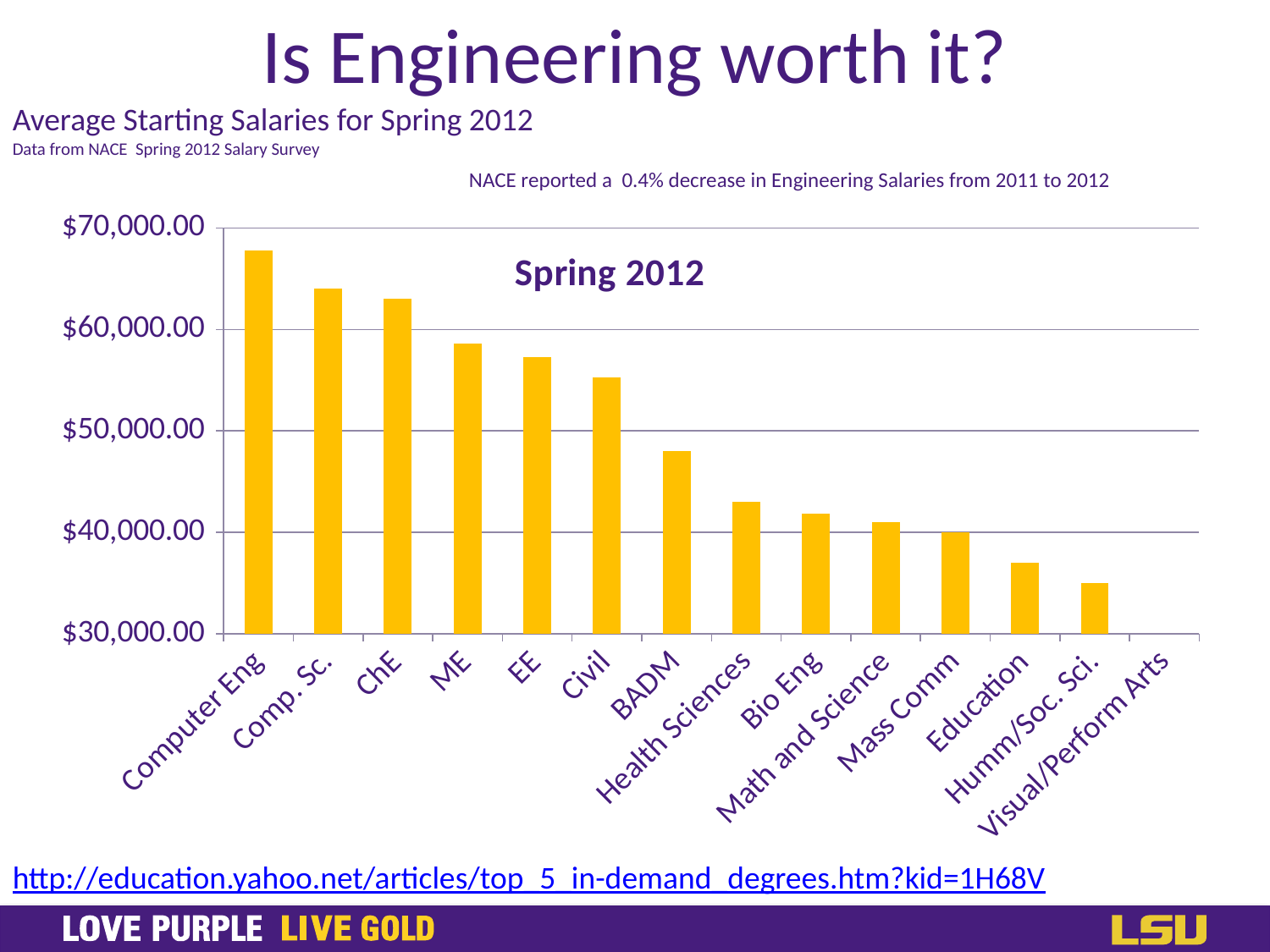
Is the value for BADM greater or less than $50,000.00? less Which has the larger value, Civil or BADM? Civil What kind of chart is shown on the slide? bar chart Do the bar values rise or fall moving left to right along the x axis? fall Is the value for Health Sciences greater or less than $40,000.00? greater How many category labels are shown on the x axis of the chart? 14 Is the value for Computer Eng greater or less than $60,000.00? greater Which category has the highest average starting salary in the chart? Computer Eng What is the title printed inside the chart? Spring 2012 Which has the larger value, Health Sciences or Education? Health Sciences